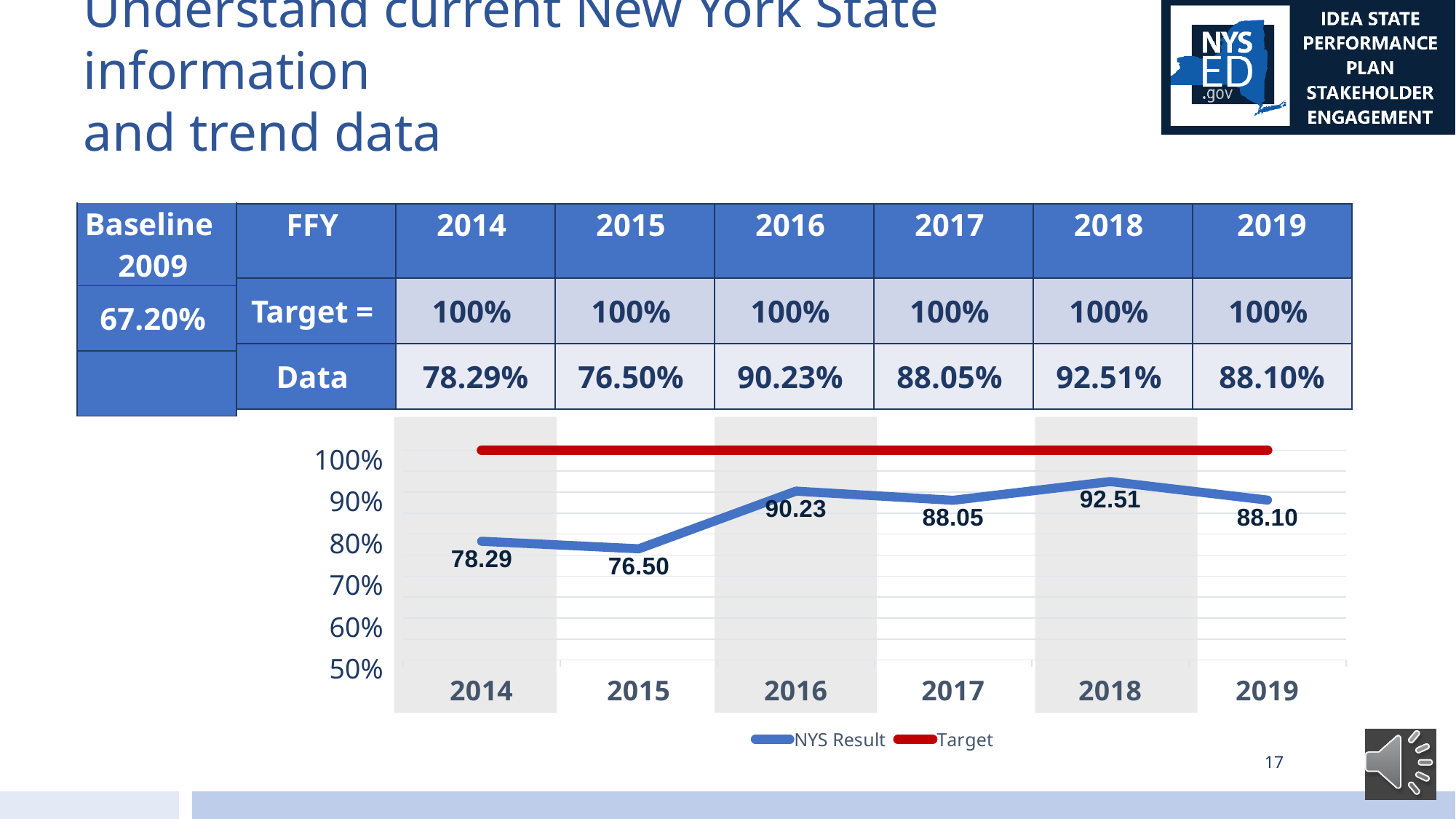
Is the NYS Result for 2017 greater or less than 80%? greater What is the NYS Result value for 2019 on the chart? 88.10 Does the NYS Result rise or fall from 2015 to 2016? rise Which year has the lowest NYS Result on the chart? 2015 What kind of chart is shown on the slide? line chart Which is larger, the NYS Result for 2014 or for 2015? 2014 How many series does the chart legend list? 2 What colour is the Target line in the chart? red How many years are plotted on the x axis of the chart? 6 Which year has the highest NYS Result on the chart? 2018 What is the difference between the NYS Result for 2018 and 2019? 4.41 What is the NYS Result value for 2016 on the chart? 90.23